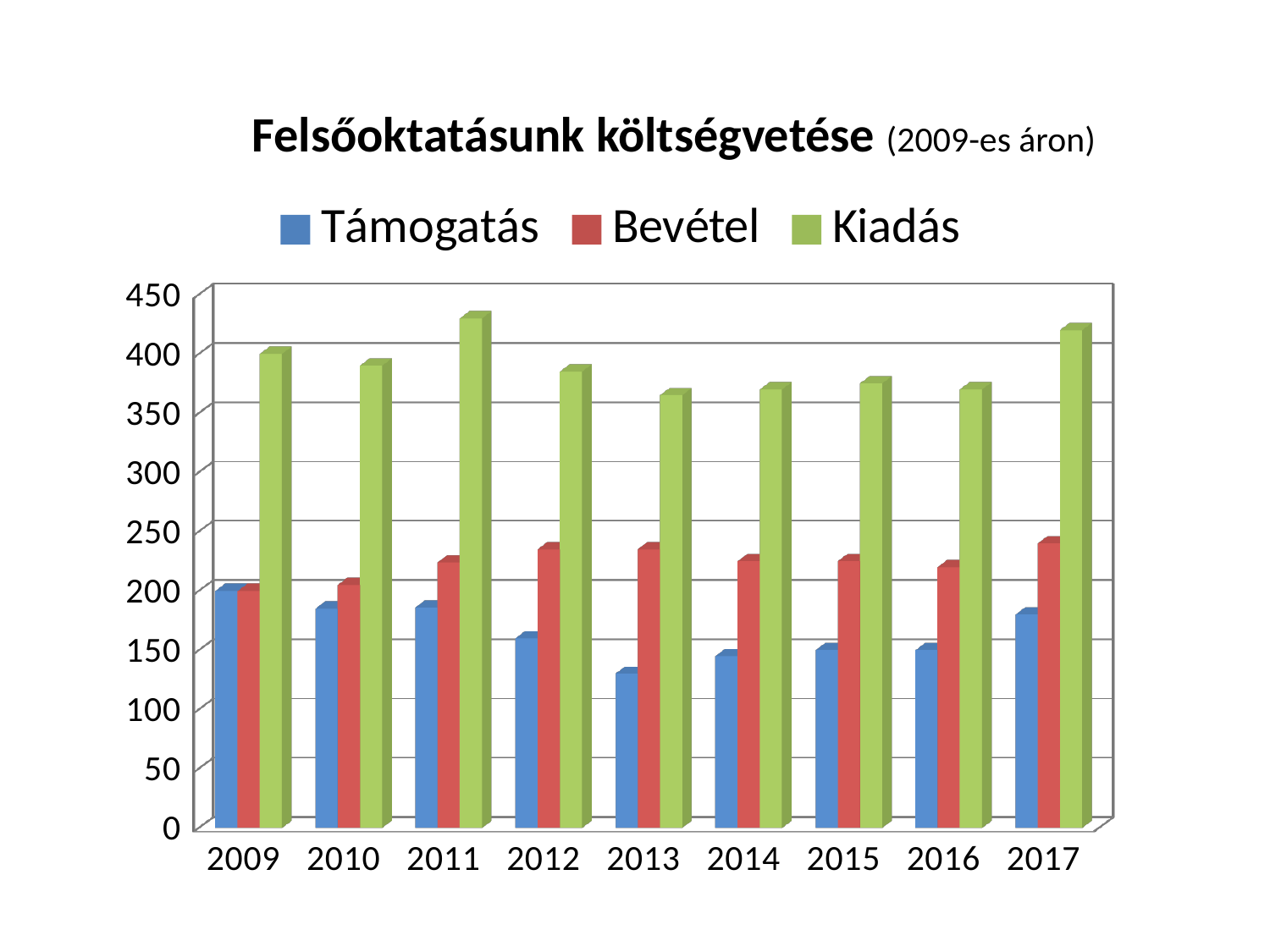
What is the title of the chart? Felsőoktatásunk költségvetése (2009-es áron) What kind of chart is shown on the slide? bar chart In which year is the Támogatás value lowest? 2013 Is the Bevétel value for 2017 greater or less than 250? less Is the Kiadás value for 2013 greater or less than 350? greater Is the Kiadás value for 2011 greater or less than 400? greater How many years are shown on the x axis? 9 In which year is the Kiadás value highest? 2011 Which is larger in 2012, Támogatás or Bevétel? Bevétel How many series does the legend list? 3 Does the Támogatás value rise or fall from 2009 to 2013? fall